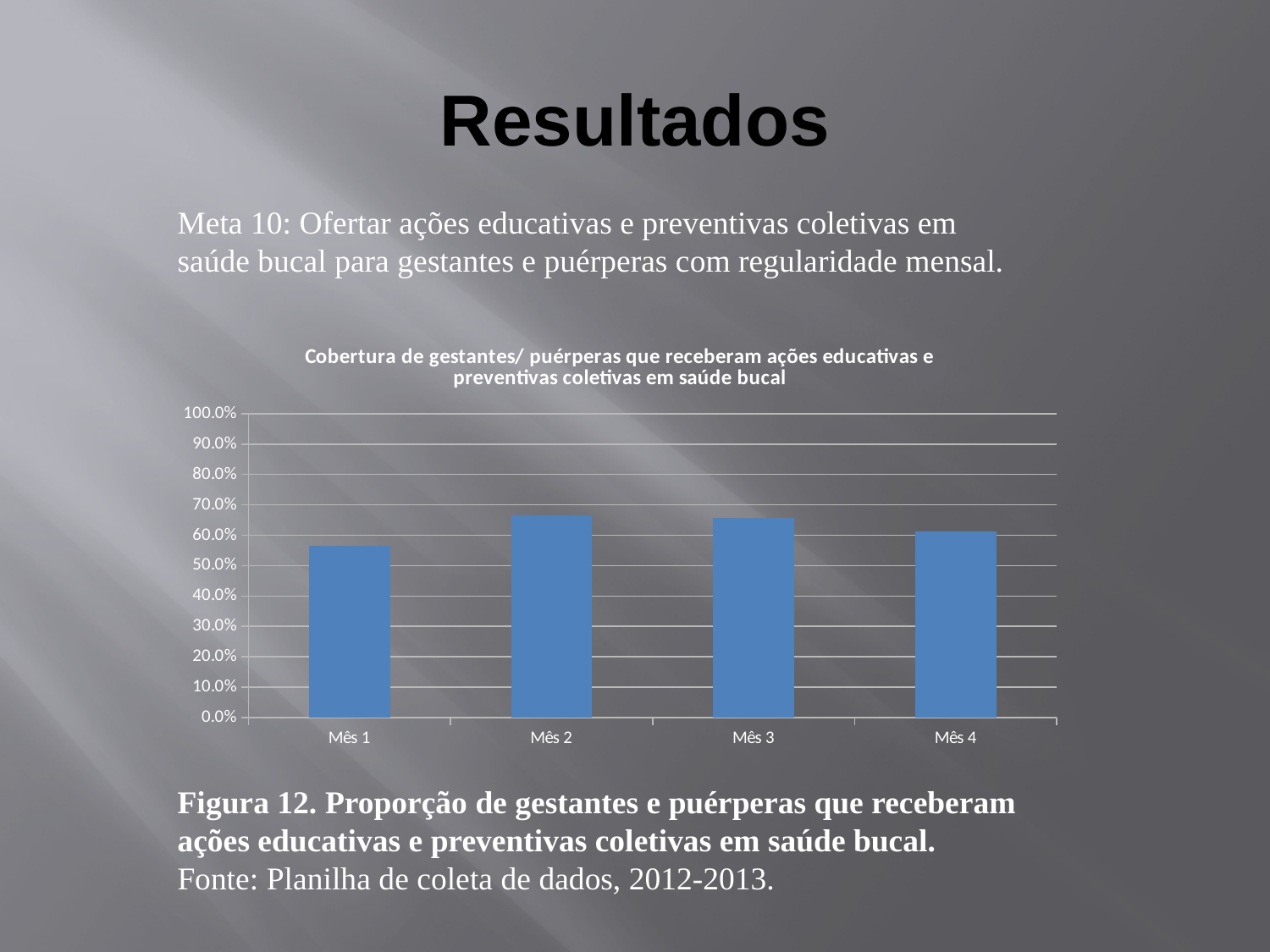
Which is larger, the value for Mês 2 or the value for Mês 4? Mês 2 Do the values rise or fall from Mês 2 to Mês 4? fall What is the highest value shown on the chart's vertical axis? 100.0% Is the value for Mês 1 greater or less than 60%? less Is the value for Mês 3 greater or less than 60%? greater How many months (categories) are plotted on the x axis of the chart? 4 Which month has the lowest coverage value in the chart? Mês 1 Is the value for Mês 1 greater or less than 50%? greater What kind of chart is shown on the slide? bar chart Which is larger, the value for Mês 1 or the value for Mês 2? Mês 2